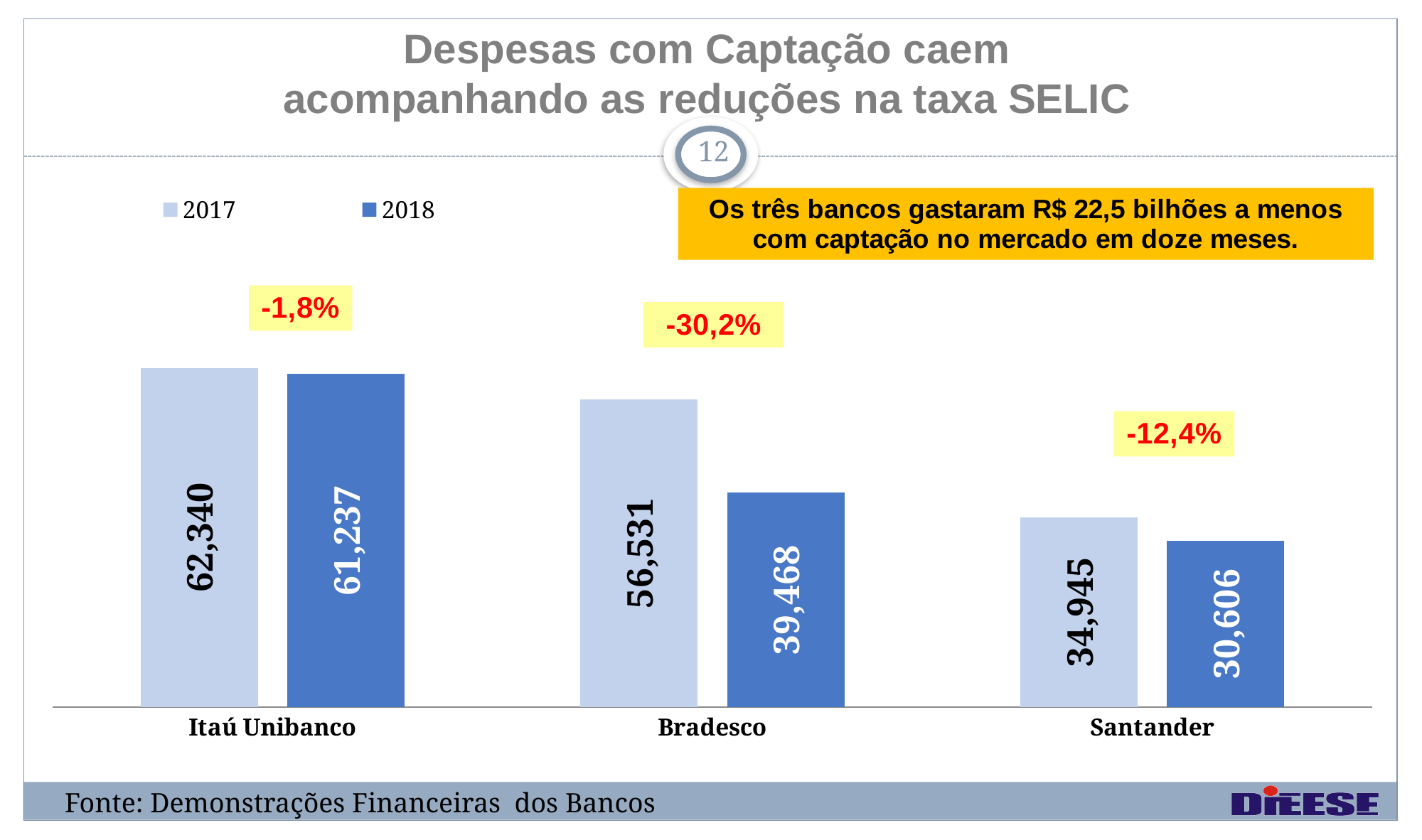
What is the 2018 value for Santander? 30,606 What percentage change is shown above the Bradesco bars? -30,2% How many banks are shown on the x axis? 3 Which is larger: the 2018 value for Bradesco or the 2017 value for Santander? 2018 value for Bradesco What is the difference between the 2017 and 2018 values for Bradesco? 17,063 How many series does the legend list? 2 Which bank has the lowest 2018 value? Santander What kind of chart is shown on the slide? Bar chart What is the 2017 value for Bradesco? 56,531 What is the difference between the 2017 and 2018 values for Santander? 4,339 Which bank has the highest 2017 value? Itaú Unibanco What is the 2018 value for Itaú Unibanco? 61,237